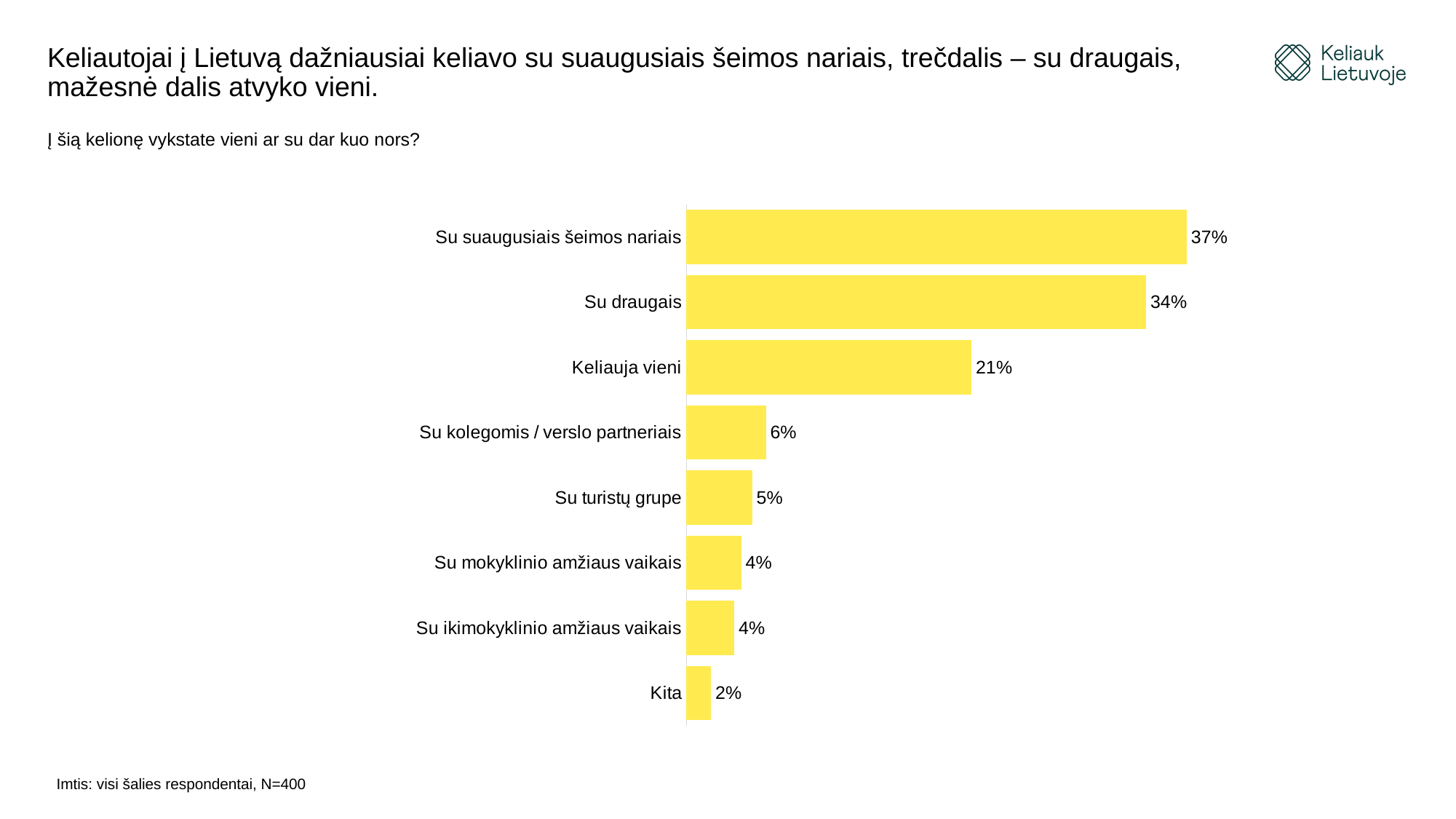
What is the difference between the values for "Su draugais" and "Keliauja vieni"? 13% What is the value for "Keliauja vieni"? 21% What is the value for "Su suaugusiais šeimos nariais"? 37% What is the value for "Kita"? 2% How many categories are shown in the chart? 8 What kind of chart is shown on the slide? Bar chart What colour are the bars in the chart? Yellow Which category has the lowest value? Kita What is the difference between the values for "Su suaugusiais šeimos nariais" and "Su draugais"? 3% Which category has the highest value? Su suaugusiais šeimos nariais Which is larger: the value for "Su kolegomis / verslo partneriais" or the value for "Su turistų grupe"? Su kolegomis / verslo partneriais What is the value for "Su turistų grupe"? 5%